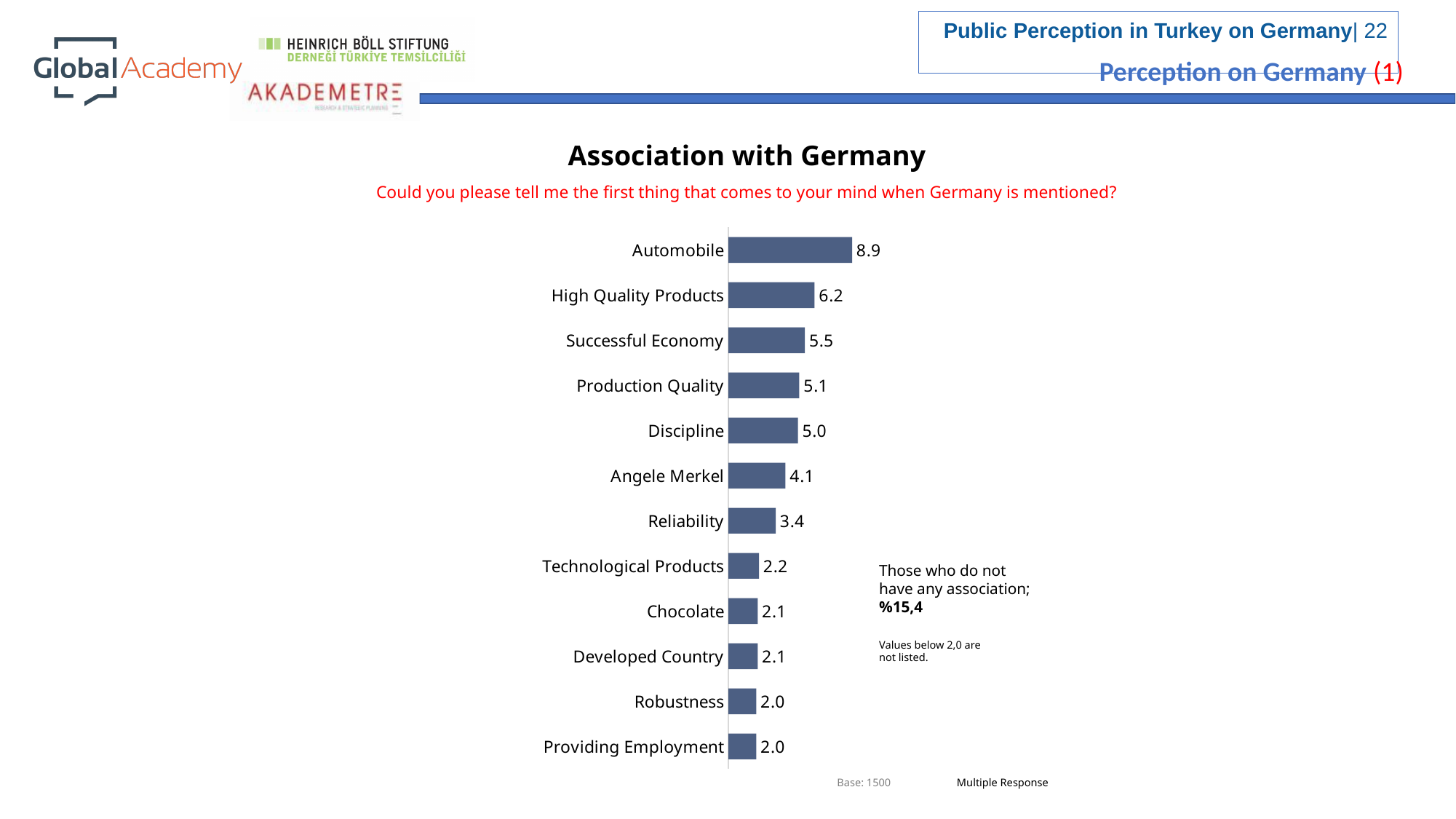
How many categories are shown in the chart? 12 What is the value for Reliability? 3.4 Which category has the highest value? Automobile Which is larger, the value for High Quality Products or the value for Production Quality? High Quality Products What is the title of the chart? Association with Germany What is the value for Angele Merkel? 4.1 What is the value for Automobile? 8.9 What is the difference between the values for Automobile and High Quality Products? 2.7 According to the note on the slide, what percentage of respondents do not have any association? %15,4 What kind of chart is shown on the slide? Bar chart Which is larger, the value for Discipline or the value for Technological Products? Discipline What is the difference between the values for Successful Economy and Reliability? 2.1